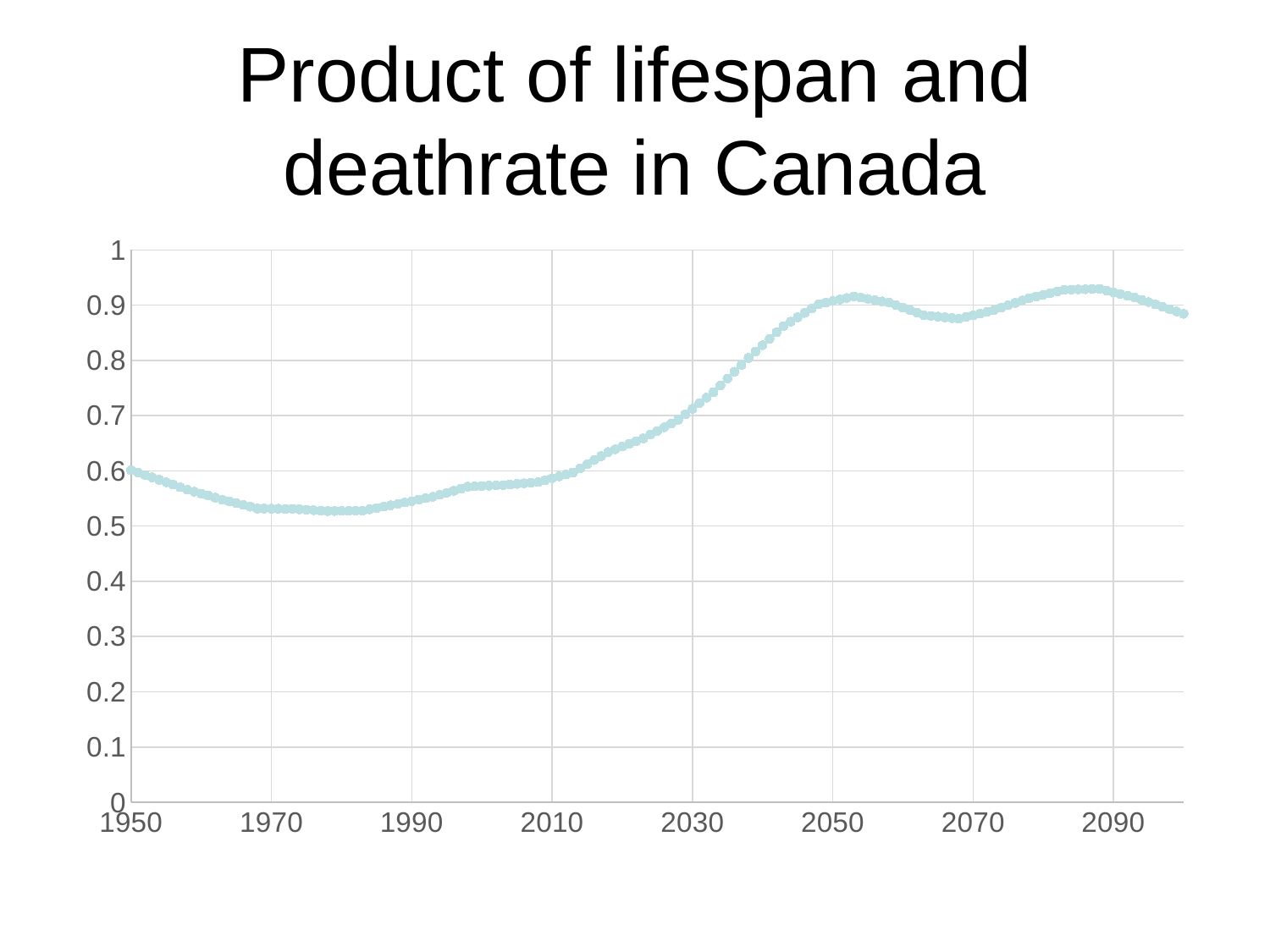
What kind of chart is shown on the slide? line chart What is the title of the chart? Product of lifespan and deathrate in Canada Do the values rise or fall between 1950 and 1970? fall Do the values rise or fall between 2010 and 2050? rise Which year has the larger value, 1970 or 2050? 2050 Is the value for 2030 greater or less than 0.6? greater Is the value for 1950 greater or less than 0.5? greater What is the first year shown on the x axis? 1950 Is the value for 2070 greater or less than 0.9? less Which year has the larger value, 2010 or 2090? 2090